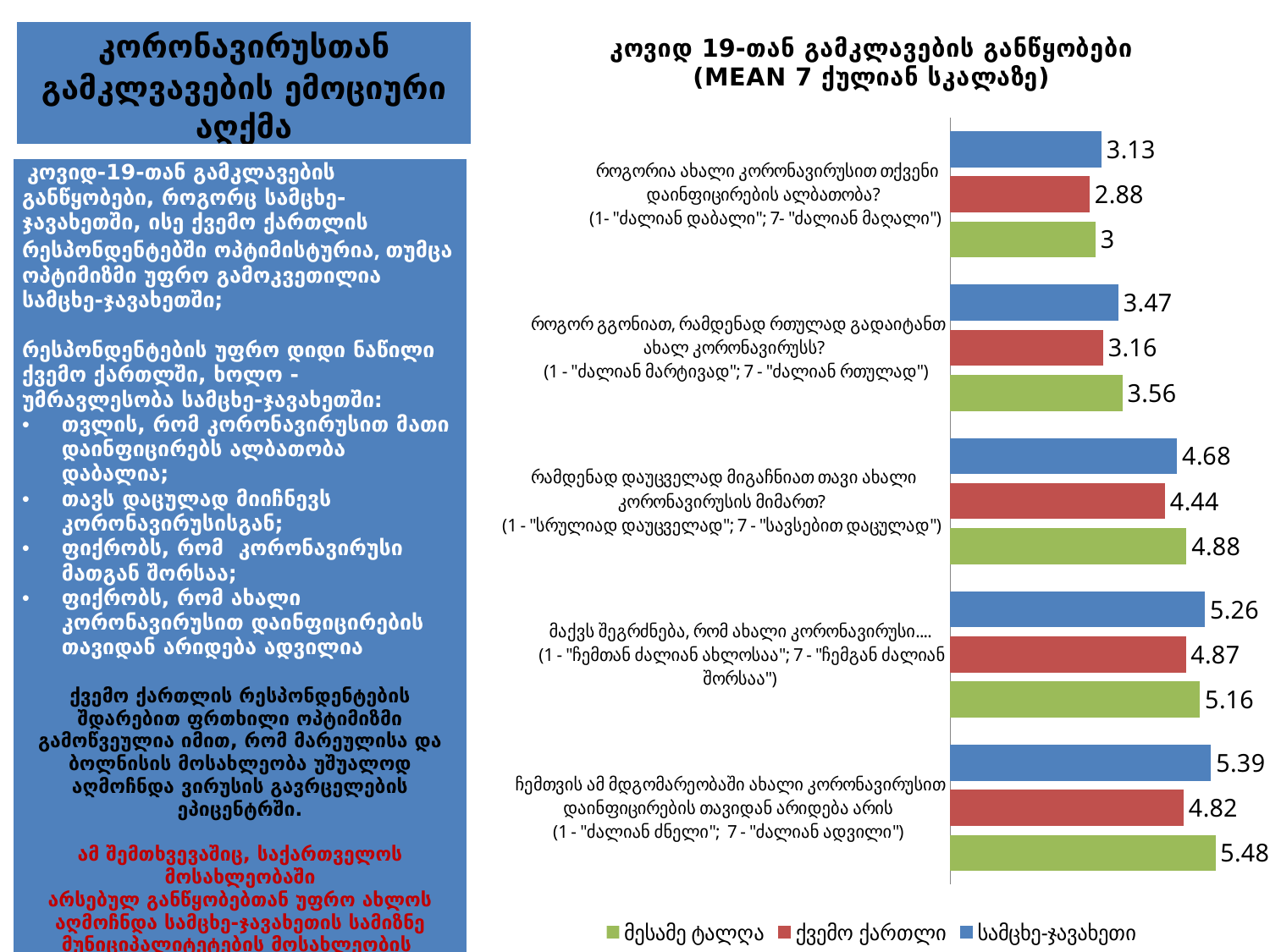
How many series does the chart legend list? 3 What is the value for სამცხე-ჯავახეთი on the question "როგორია ახალი კორონავირუსით თქვენი დაინფიცირების ალბათობა?"? 3.13 Which colour represents ქვემო ქართლი in the chart legend? red What type of chart is shown on the slide? bar chart Which is larger on the question "რამდენად დაუცველად მიგაჩნიათ თავი ახალი კორონავირუსის მიმართ?": the value for მესამე ტალღა or for სამცხე-ჯავახეთი? მესამე ტალღა What is the value for ქვემო ქართლი on the question "მაქვს შეგრძნება, რომ ახალი კორონავირუსი...."? 4.87 What is the difference between the სამცხე-ჯავახეთი and ქვემო ქართლი values on the question "ჩემთვის ამ მდგომარეობაში ახალი კორონავირუსით დაინფიცირების თავიდან არიდება არის"? 0.57 How many question categories are plotted on the chart? 5 What is the value for მესამე ტალღა on the question "ჩემთვის ამ მდგომარეობაში ახალი კორონავირუსით დაინფიცირების თავიდან არიდება არის"? 5.48 Which series has the lowest value on the question "როგორ გგონიათ, რამდენად რთულად გადაიტანთ ახალ კორონავირუსს?"? ქვემო ქართლი Which series has the highest value on the question "მაქვს შეგრძნება, რომ ახალი კორონავირუსი...."? სამცხე-ჯავახეთი What is the value for ქვემო ქართლი on the question "რამდენად დაუცველად მიგაჩნიათ თავი ახალი კორონავირუსის მიმართ?"? 4.44